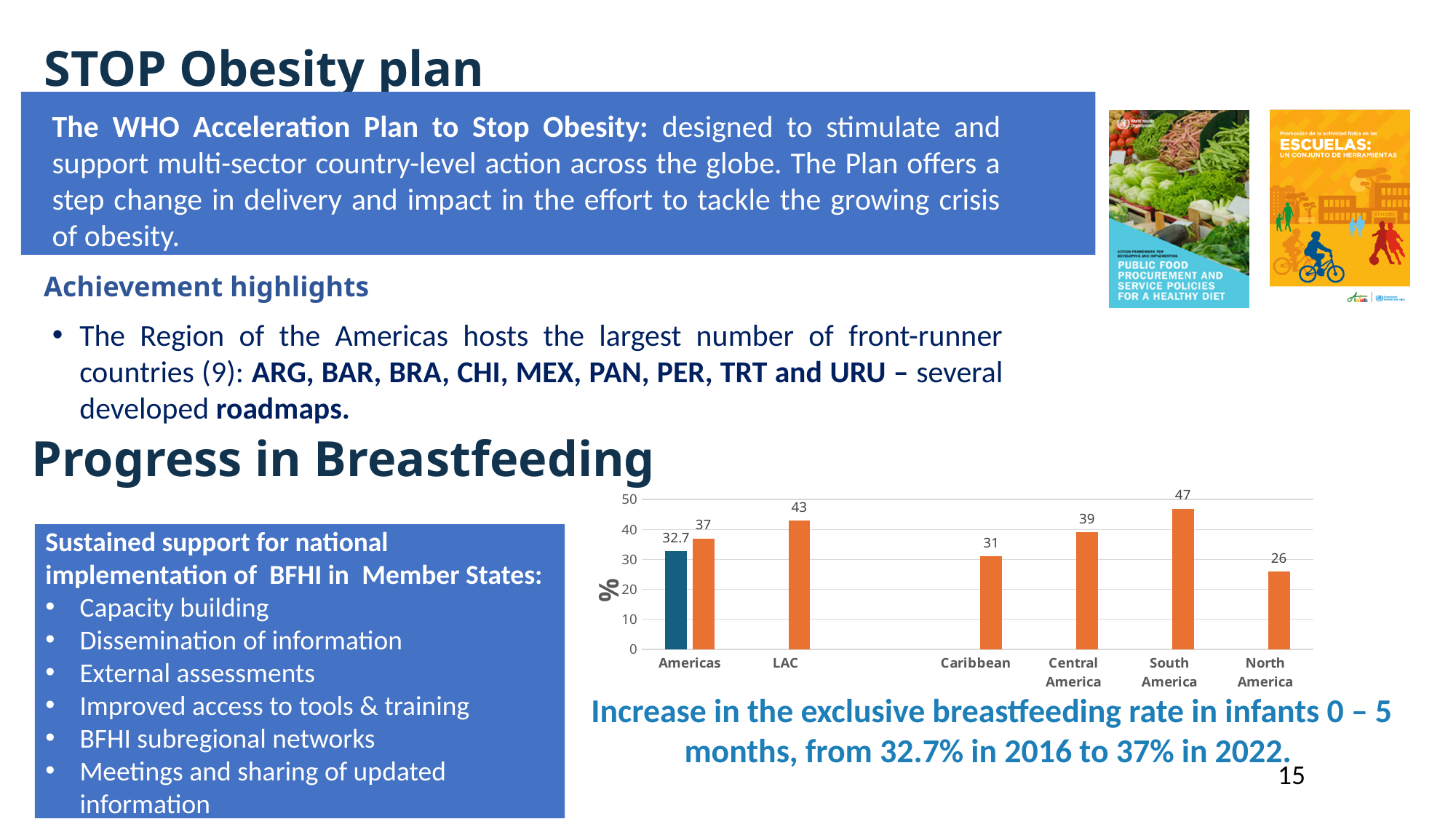
What kind of chart is shown on the slide? Bar chart Which is larger, the value for Central America or the value for Caribbean? Central America What is the difference between the values for South America and Caribbean? 16 Which category has the highest value in the chart? South America What is the value of the orange bar for LAC? 43 What is the value shown for North America? 26 Which category has the lowest value in the chart? North America How many category labels are shown on the x axis of the chart? 6 What is the label on the y axis of the chart? % What is the value shown for South America? 47 What is the difference between the orange bar and the blue bar for Americas? 4.3 What is the value of the blue bar for Americas? 32.7